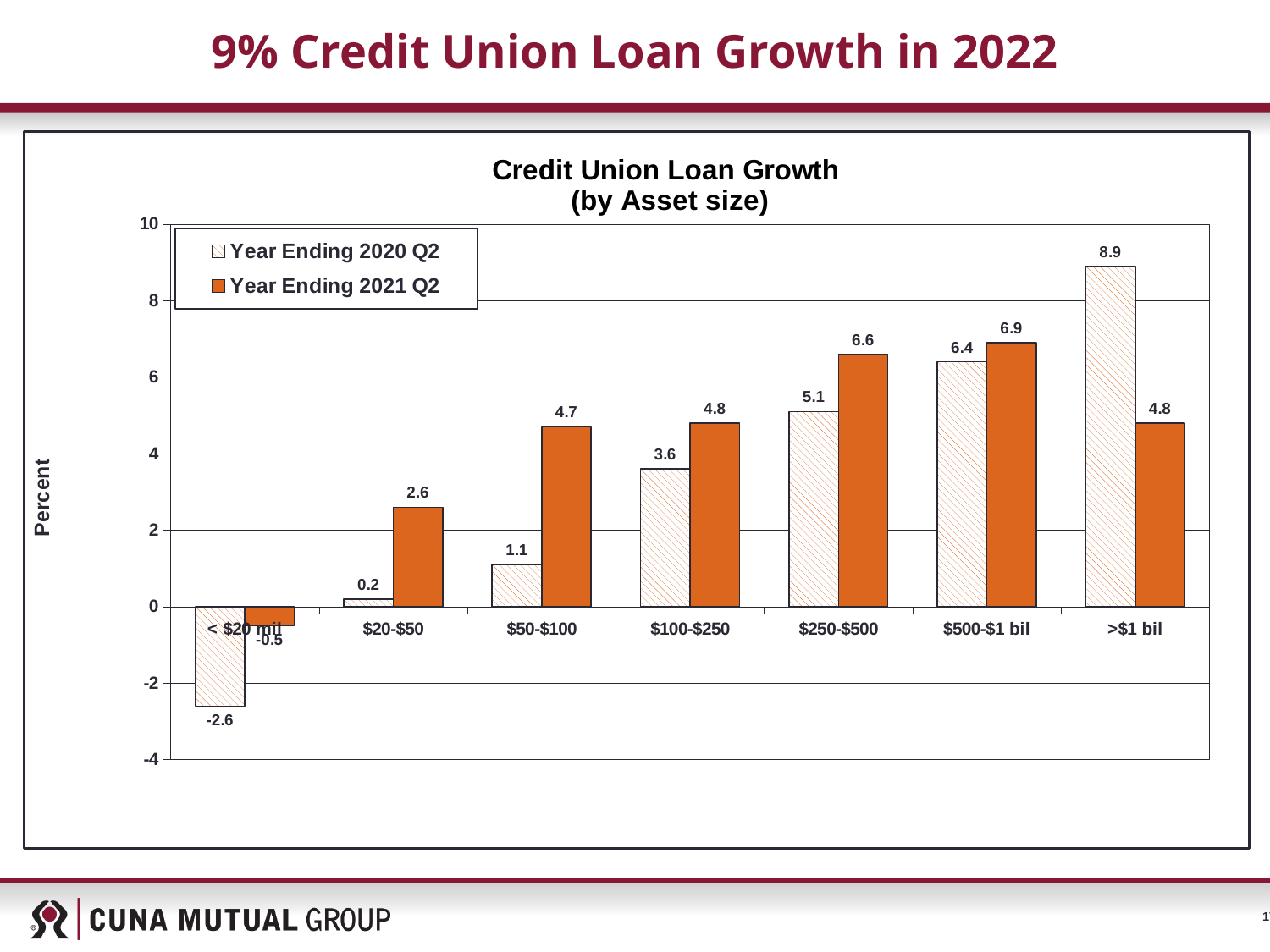
For the $250-$500 group, which is larger: Year Ending 2020 Q2 or Year Ending 2021 Q2 loan growth? Year Ending 2021 Q2 Do the Year Ending 2020 Q2 values rise or fall as asset size increases from < $20 mil to >$1 bil? Rise How many asset size groups are shown on the x axis? 7 Which asset size group has the highest Year Ending 2021 Q2 loan growth? $500-$1 bil What is the label on the vertical axis of the chart? Percent What is the difference between the Year Ending 2020 Q2 and Year Ending 2021 Q2 loan growth for the >$1 bil group? 4.1 What is the Year Ending 2020 Q2 loan growth for the < $20 mil asset size group? -2.6 Which asset size group has the lowest Year Ending 2020 Q2 loan growth? < $20 mil What is the Year Ending 2020 Q2 loan growth for the >$1 bil asset size group? 8.9 What kind of chart is shown on the slide? Bar chart How many series does the legend list? 2 What is the Year Ending 2021 Q2 loan growth for the $50-$100 asset size group? 4.7